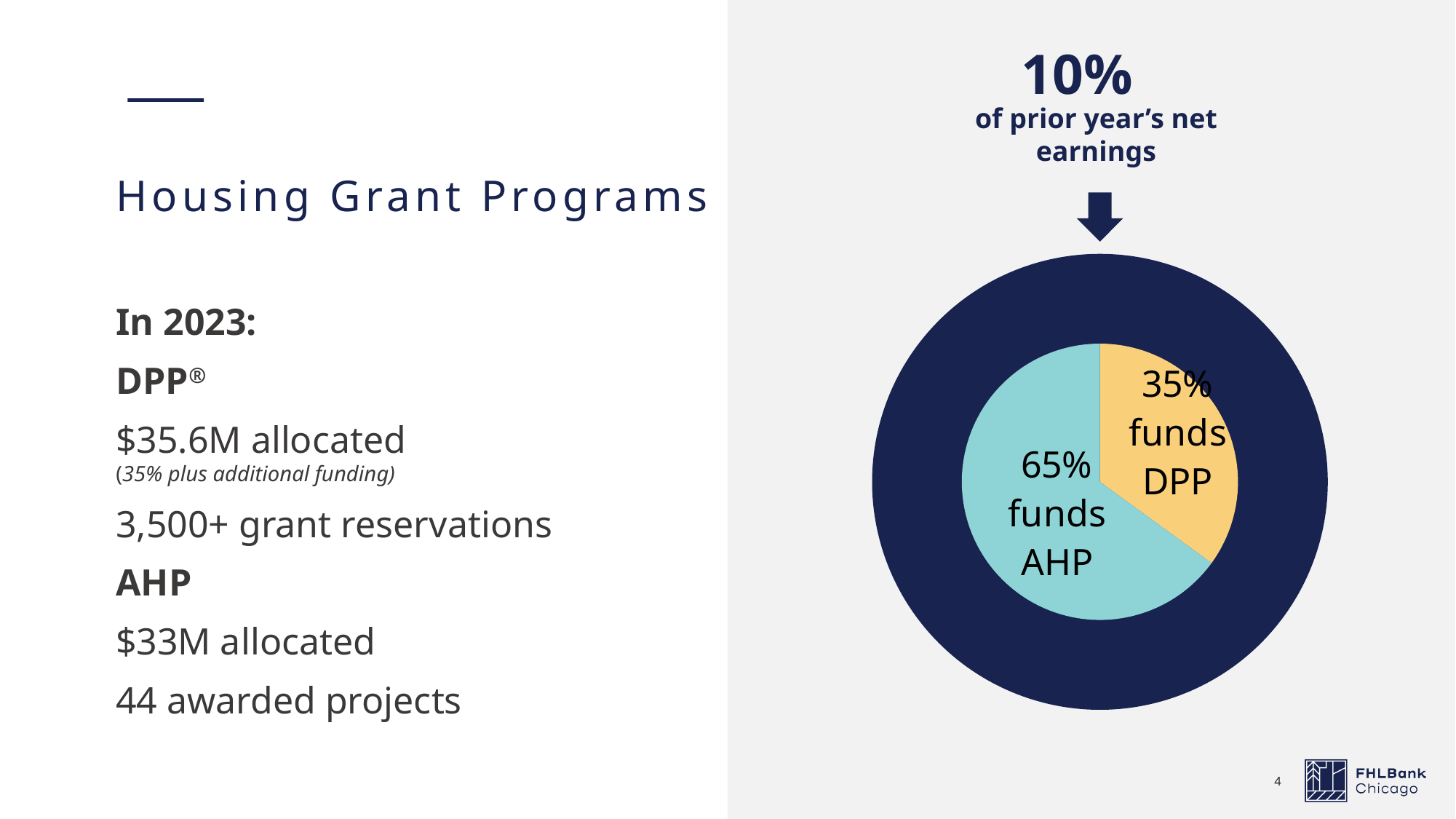
What kind of chart is shown on the slide? Pie chart Which slice of the pie chart is the largest? AHP What share of the pie chart funds DPP? 35% What percentage of prior year's net earnings is shown above the pie chart? 10% Which program receives the larger share of the pie chart, DPP or AHP? AHP Which slice of the pie chart is the smallest? DPP What share of the pie chart funds AHP? 65% How many slices does the pie chart have? 2 What colour is the AHP slice of the pie chart? Light blue (teal) Is the share for DPP in the pie chart greater or less than 50%? less What is the difference in percentage points between the AHP share and the DPP share in the pie chart? 30 percentage points